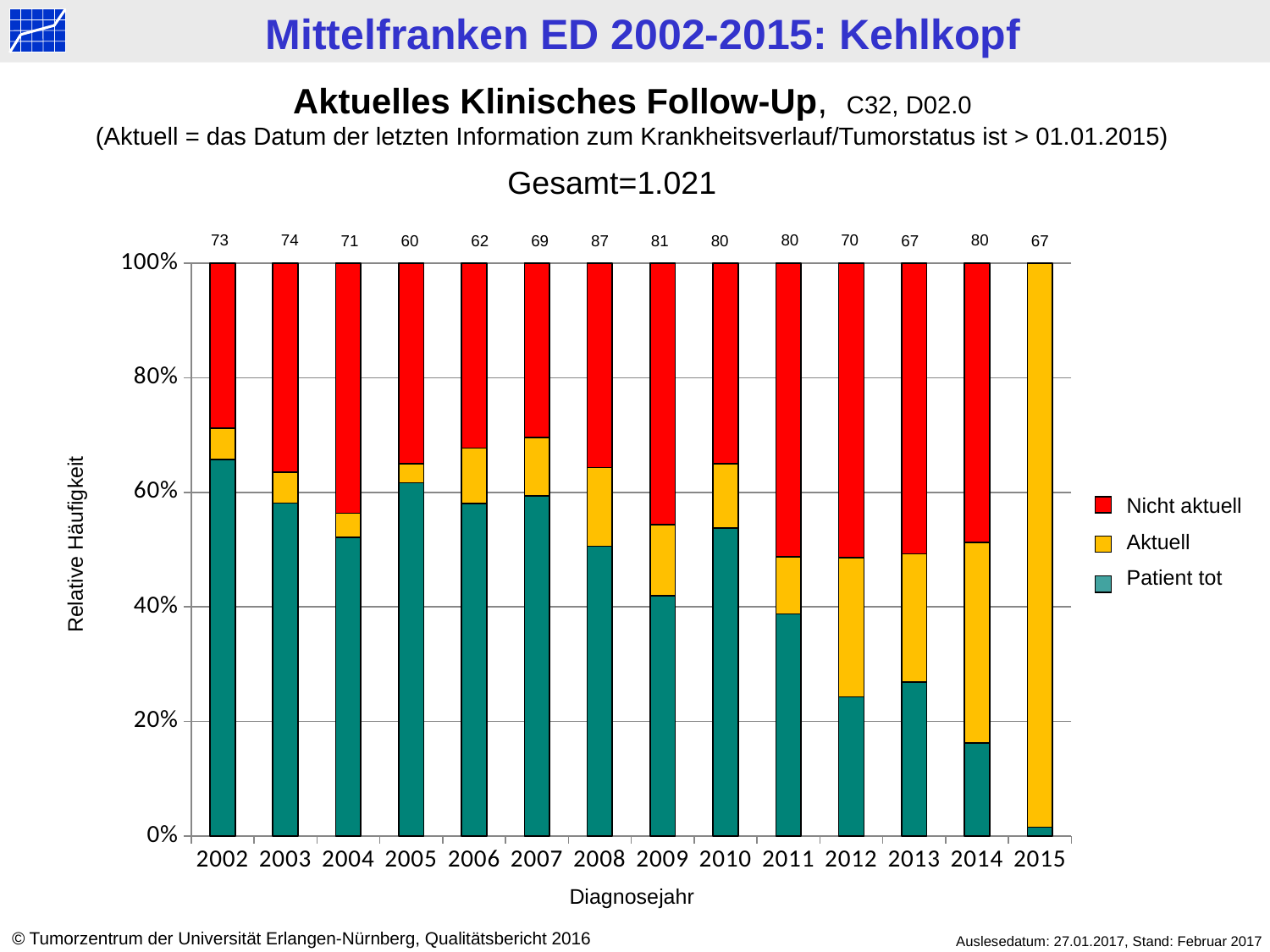
What kind of chart is shown on the slide? bar chart How many series does the legend list? 3 Is the 'Patient tot' share for 2014 greater or less than 20%? less Which diagnosis year has the lowest number printed above its bar? 2005 What number is printed above the bar for 2005? 60 How many diagnosis years (categories) are shown on the x axis? 14 Which diagnosis year has the highest number printed above its bar? 2008 Is the 'Patient tot' share for 2002 greater or less than 60%? greater Which colour represents 'Nicht aktuell' in the legend? red What number is printed above the bar for 2008? 87 What is the difference between the numbers printed above the bars for 2008 and 2005? 27 Which year has a larger 'Patient tot' share, 2002 or 2014? 2002